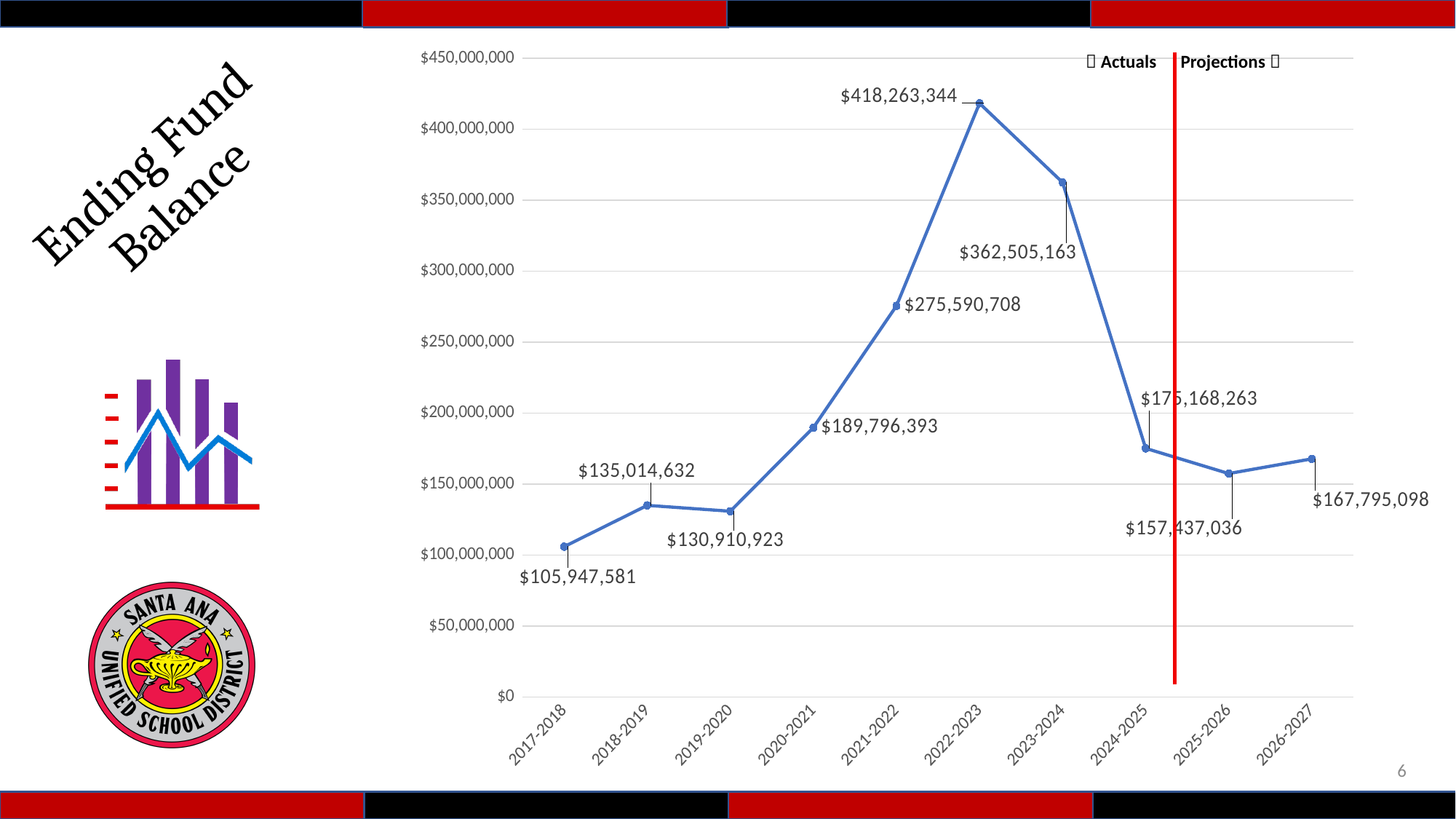
How many fiscal years are plotted on the x axis? 10 What kind of chart is shown on the slide? line chart What is the ending fund balance for 2017-2018? $105,947,581 Is the ending fund balance for 2024-2025 greater or less than $200,000,000? less What do the labels on either side of the red vertical line say? Actuals and Projections What is the ending fund balance for 2022-2023? $418,263,344 What is the ending fund balance for 2021-2022? $275,590,708 By how much does the ending fund balance for 2022-2023 exceed that for 2023-2024? $55,758,181 Which fiscal year has the highest ending fund balance? 2022-2023 Which fiscal year has the lowest ending fund balance? 2017-2018 Which is larger, the ending fund balance for 2018-2019 or for 2019-2020? 2018-2019 What is the ending fund balance for 2020-2021? $189,796,393